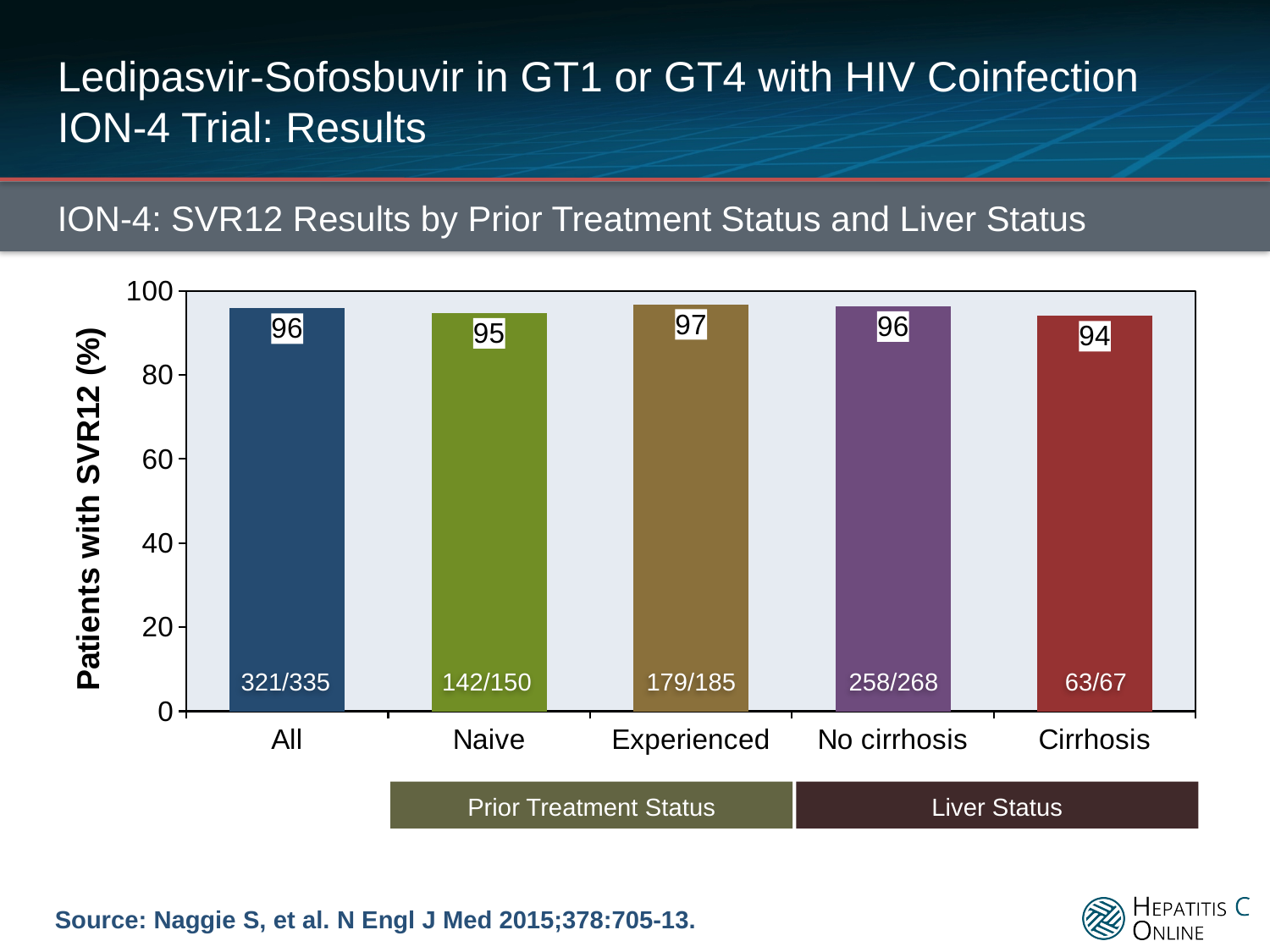
What fraction of patients is shown for the All group? 321/335 What is the difference in SVR12 rate between the Experienced and Cirrhosis groups? 3 Which has a higher SVR12 rate, Naive or Experienced? Experienced What is the SVR12 rate for the Cirrhosis group? 94 What fraction of patients is shown for the Naive group? 142/150 What is the label of the y axis? Patients with SVR12 (%) Is the SVR12 rate for the No cirrhosis group greater or less than 80? greater Which category has the lowest SVR12 rate? Cirrhosis How many categories are shown on the x axis? 5 What is the SVR12 rate for the Experienced group? 97 What kind of chart is shown on the slide? Bar chart Which category has the highest SVR12 rate? Experienced